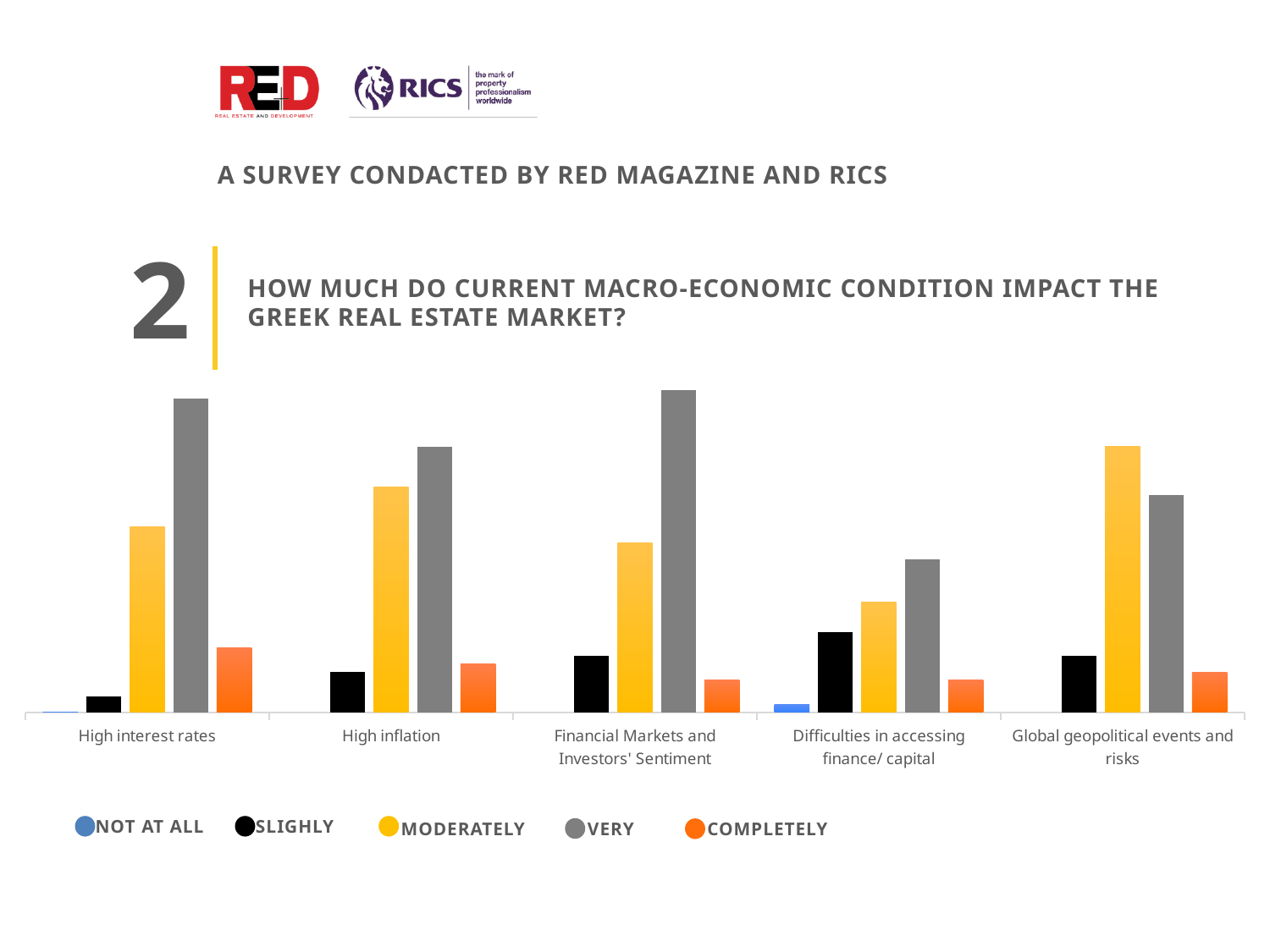
For the 'High interest rates' category, which response level has the tallest bar? Very What kind of chart is shown on the slide? bar chart Which colour does the legend use for the 'Very' series? grey Which category has the tallest 'Moderately' bar? Global geopolitical events and risks How many series does the chart's legend list? 5 Which category has the larger 'Completely' bar: 'High interest rates' or 'High inflation'? High interest rates Which category has the tallest 'Very' bar? Financial Markets and Investors' Sentiment How many categories are shown along the x axis of the chart? 5 For 'Difficulties in accessing finance/ capital', which is larger: the 'Slightly' bar or the 'Moderately' bar? Moderately For 'High inflation', which is larger: the 'Moderately' bar or the 'Very' bar? Very